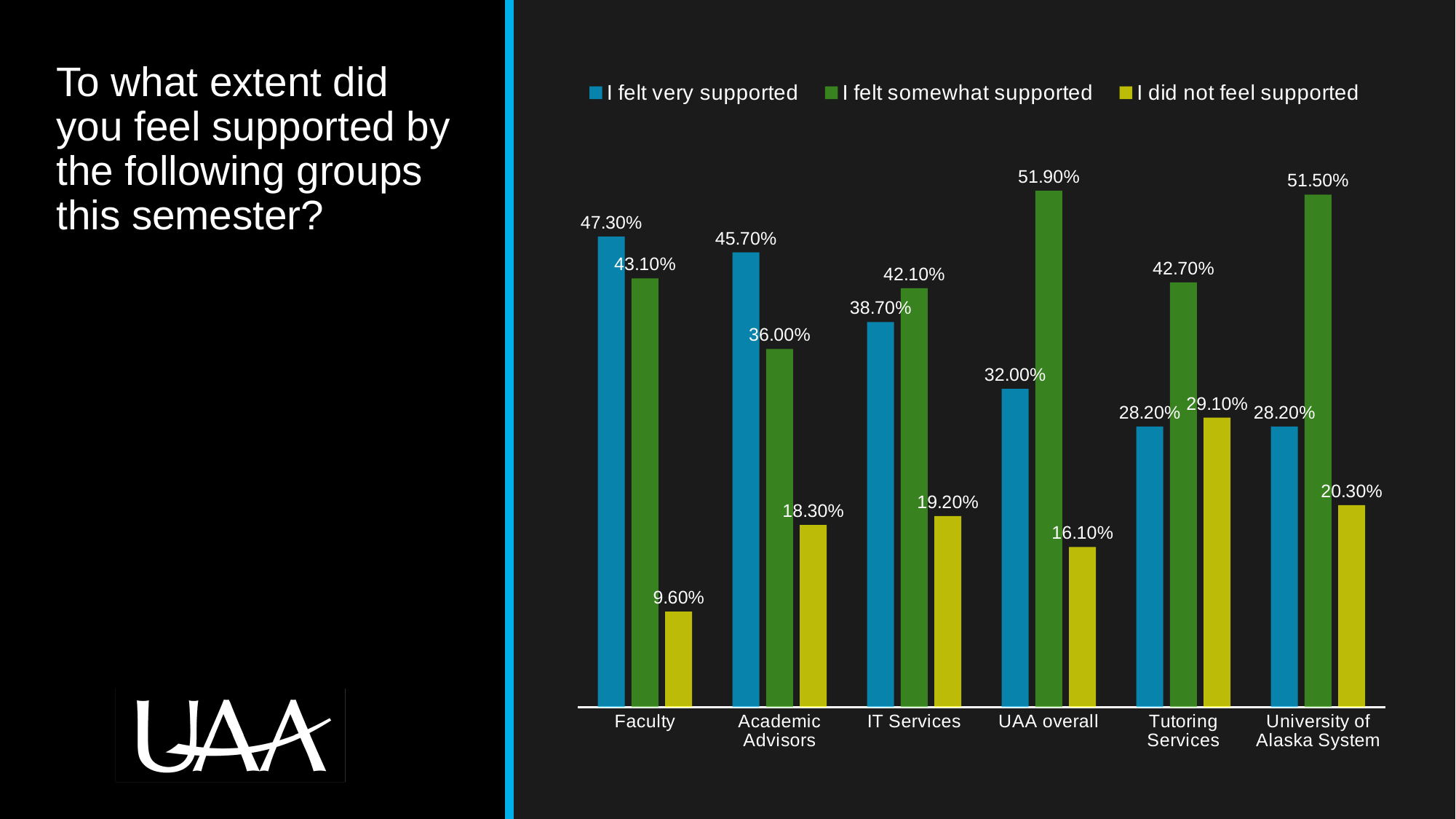
For IT Services, which is larger: "I felt very supported" or "I felt somewhat supported"? I felt somewhat supported What percentage said "I felt somewhat supported" for UAA overall? 51.90% Which group has the highest "I felt very supported" value? Faculty What is the value for "I did not feel supported" for Academic Advisors? 18.30% Which group has the highest "I did not feel supported" value? Tutoring Services What is the "I felt very supported" value for Tutoring Services? 28.20% Which group has the lowest "I did not feel supported" value? Faculty How many series does the legend list? 3 For Faculty, what is the difference between "I felt very supported" and "I did not feel supported"? 37.70% How many groups are shown on the x axis? 6 For UAA overall, how much larger is "I felt somewhat supported" than "I felt very supported"? 19.90% What percentage of respondents said "I felt very supported" by Faculty? 47.30%